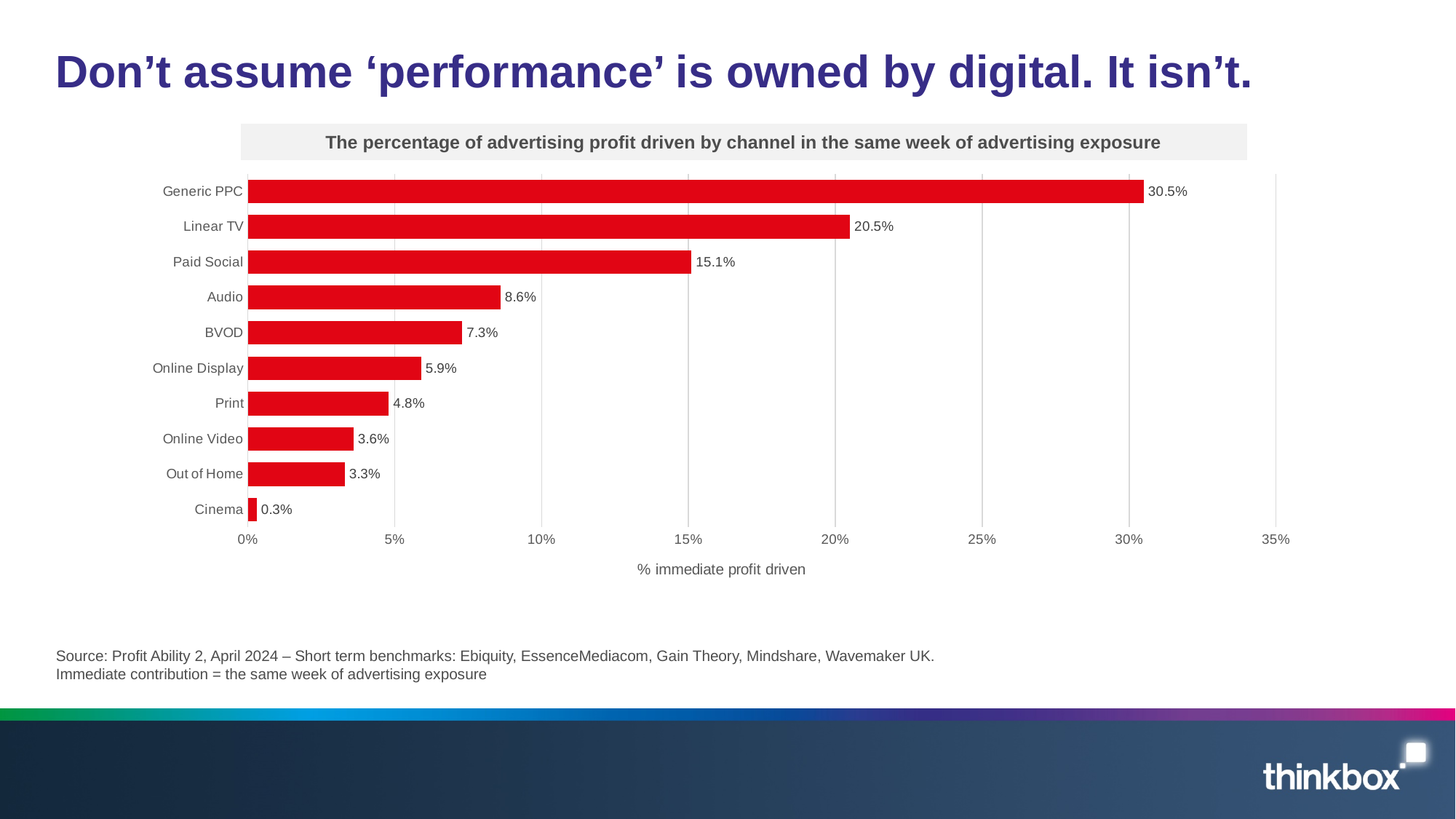
What is the difference between the values for Generic PPC and Linear TV? 10 percentage points Is the value for Paid Social greater or less than 10%? greater Which drives a larger share of immediate profit, Print or Online Video? Print Which channel drives the highest percentage of immediate profit? Generic PPC What is the difference between the values for Audio and Online Display? 2.7 percentage points What is the value shown for Paid Social? 15.1% What percentage of immediate profit is driven by BVOD? 7.3% Which channel drives the lowest percentage of immediate profit? Cinema What type of chart is shown on the slide? Bar chart What percentage of immediate profit is driven by Linear TV? 20.5% What is the label on the horizontal axis of the chart? % immediate profit driven How many channels are shown in the chart? 10